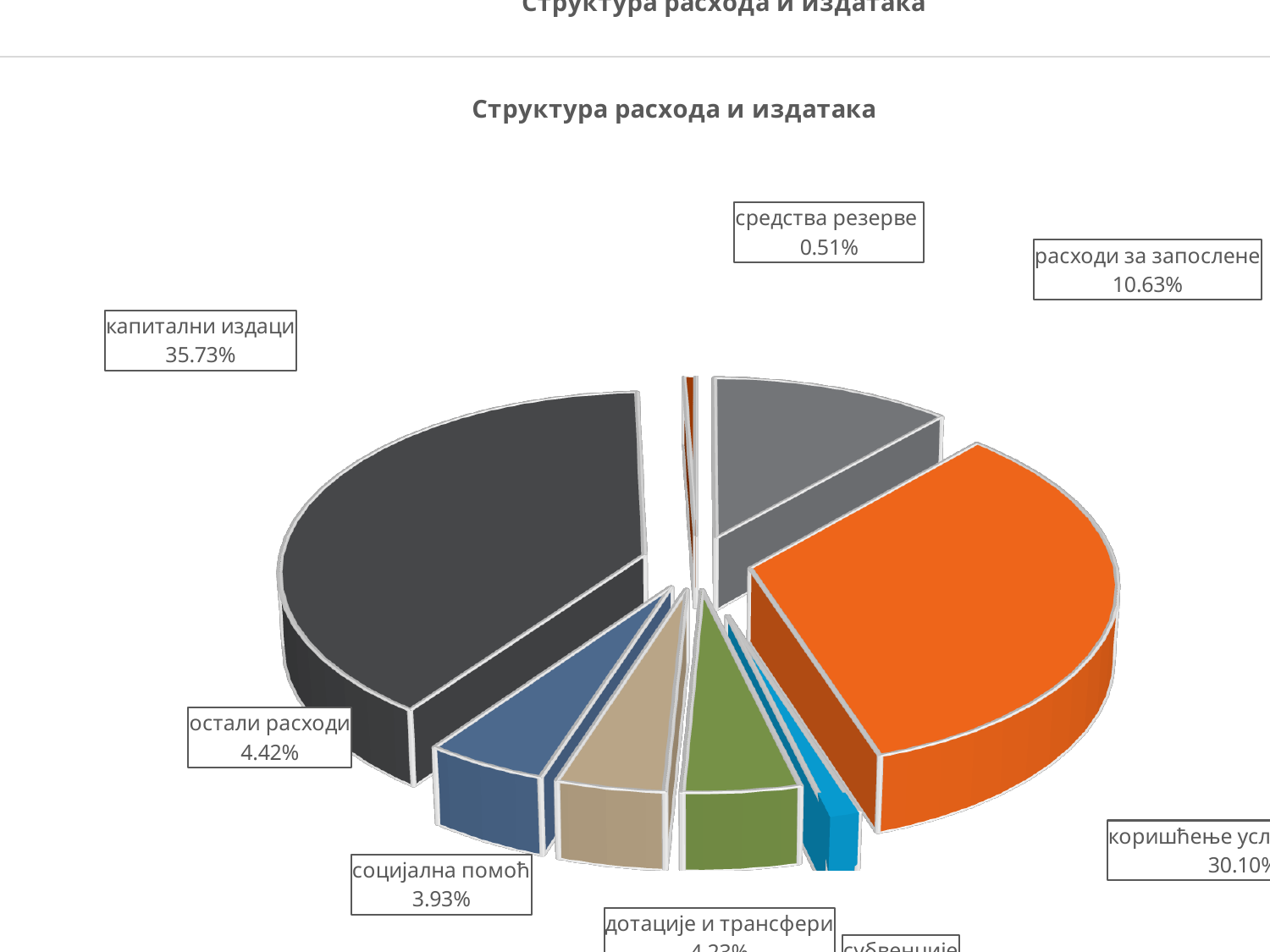
What is the title of the chart? Структура расхода и издатака What share does расходи за запослене have in the pie chart? 10.63% Which category has the largest share of the pie? капитални издаци Which has the larger share: расходи за запослене or средства резерве? расходи за запослене What share does капитални издаци have in the pie chart? 35.73% Which has the larger share: остали расходи or социјална помоћ? остали расходи What share does средства резерве have in the pie chart? 0.51% By how many percentage points does the share of капитални издаци exceed that of расходи за запослене? 25.10 percentage points What kind of chart is shown on the slide? pie chart What share does остали расходи have in the pie chart? 4.42% By how many percentage points does the share of остали расходи exceed that of социјална помоћ? 0.49 percentage points What share does социјална помоћ have in the pie chart? 3.93%